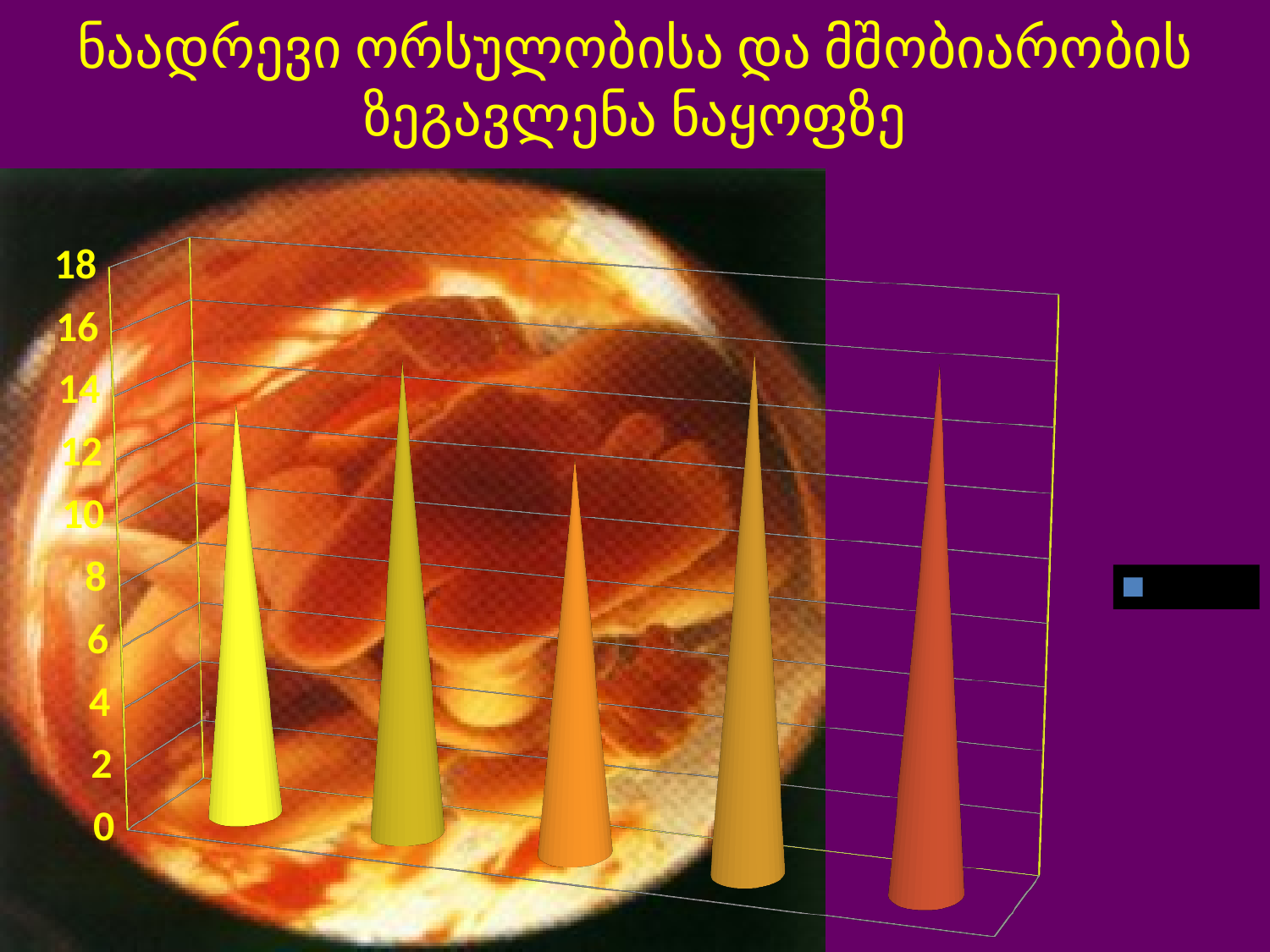
Which is larger, the value of the first bar from the left or the third bar from the left? the first bar Which is larger, the value of the second bar from the left or the third bar from the left? the second bar How many bars (cones) are plotted in the chart? 5 What kind of chart is shown on the slide? bar chart Is the value of the second bar from the left greater or less than 10? greater Is the value of the fifth bar from the left greater or less than 10? greater What is the highest value shown on the chart's vertical axis? 18 Which bar, counted from the left, has the lowest value? the third Is the value of the third bar from the left greater or less than 14? less What is the interval between consecutive tick labels on the vertical axis? 2 How many series does the chart's legend list? 1